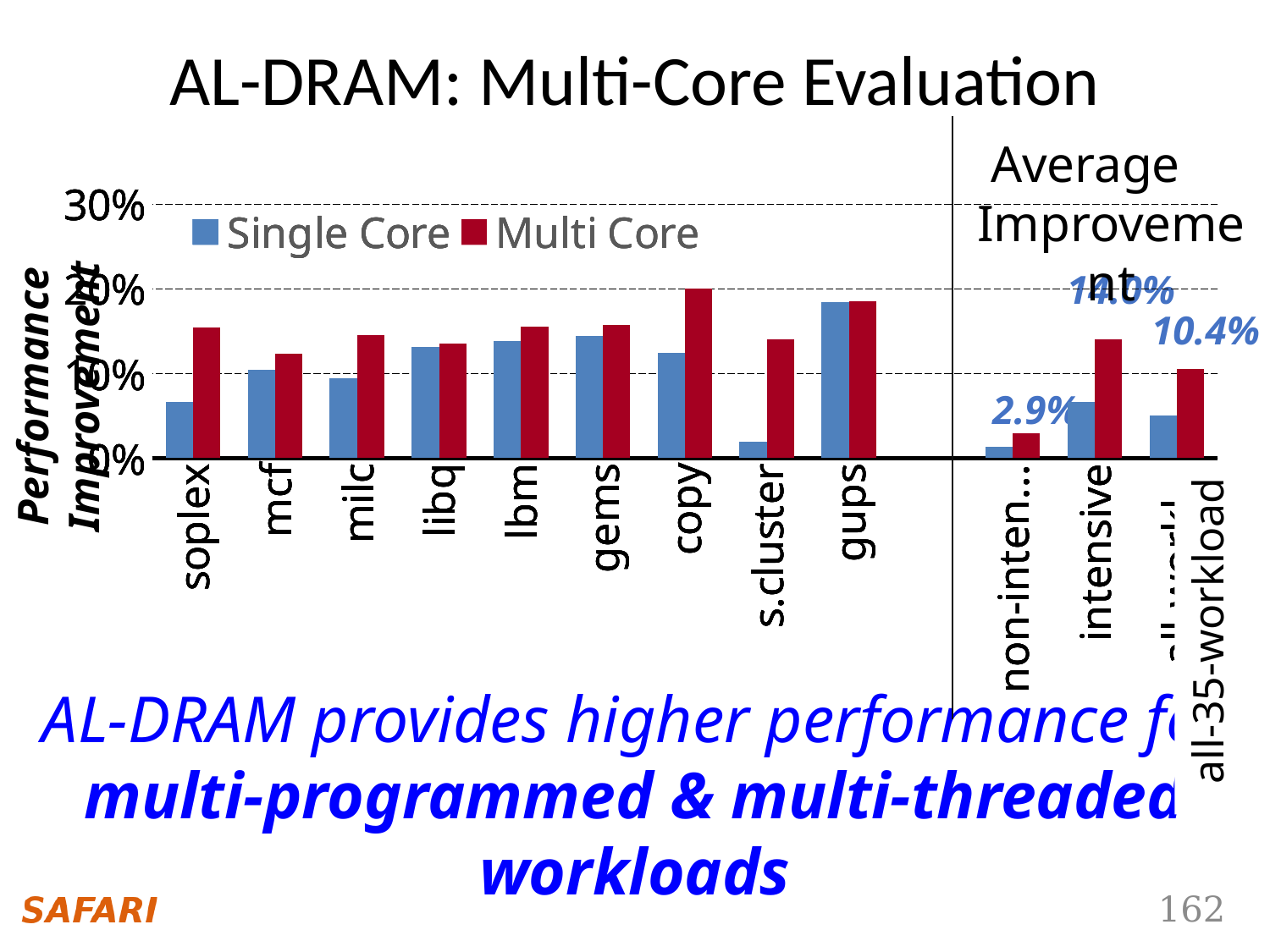
What are the two series named in the legend? Single Core and Multi Core What data label is printed above the all-35-workload group? 10.4% What kind of chart is shown on the slide? bar chart How many series does the legend list? 2 What is the title of the chart? AL-DRAM: Multi-Core Evaluation Is the Single Core value for soplex greater or less than 10%? less Which benchmark has the highest Single Core bar? gups Is the Multi Core value for gups greater or less than 10%? greater What data label is printed above the non-intensive group? 2.9% Which of the nine benchmarks has the lowest Single Core bar? s.cluster For s.cluster, which is larger: the Single Core bar or the Multi Core bar? Multi Core How many benchmark categories are plotted to the left of the vertical divider line? 9